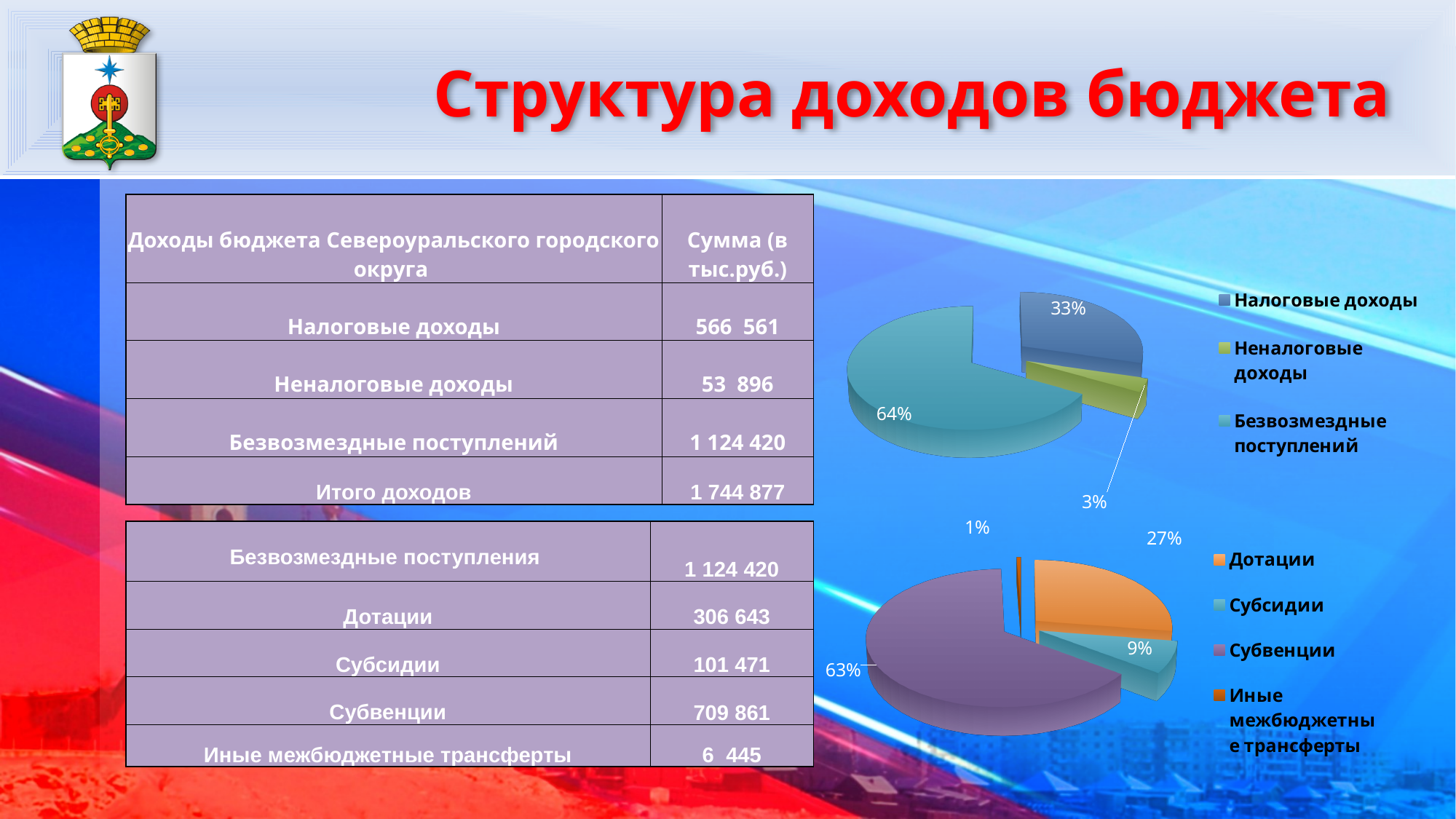
In the bottom pie chart, what is the difference in percentage points between Дотации and Субсидии? 18 In the top pie chart, what share is labelled for Неналоговые доходы? 3% In the bottom pie chart, what share is labelled for Дотации? 27% How many slices does the bottom pie chart have? 4 In the top pie chart, which category has the largest slice? Безвозмездные поступлений How many categories does the legend of the top pie chart list? 3 In the top pie chart, what share is labelled for Налоговые доходы? 33% In the bottom pie chart, which category has the smallest slice? Иные межбюджетные трансферты In the top pie chart, which category has the smallest slice? Неналоговые доходы What type of chart is the top chart on the right side of the slide? pie chart